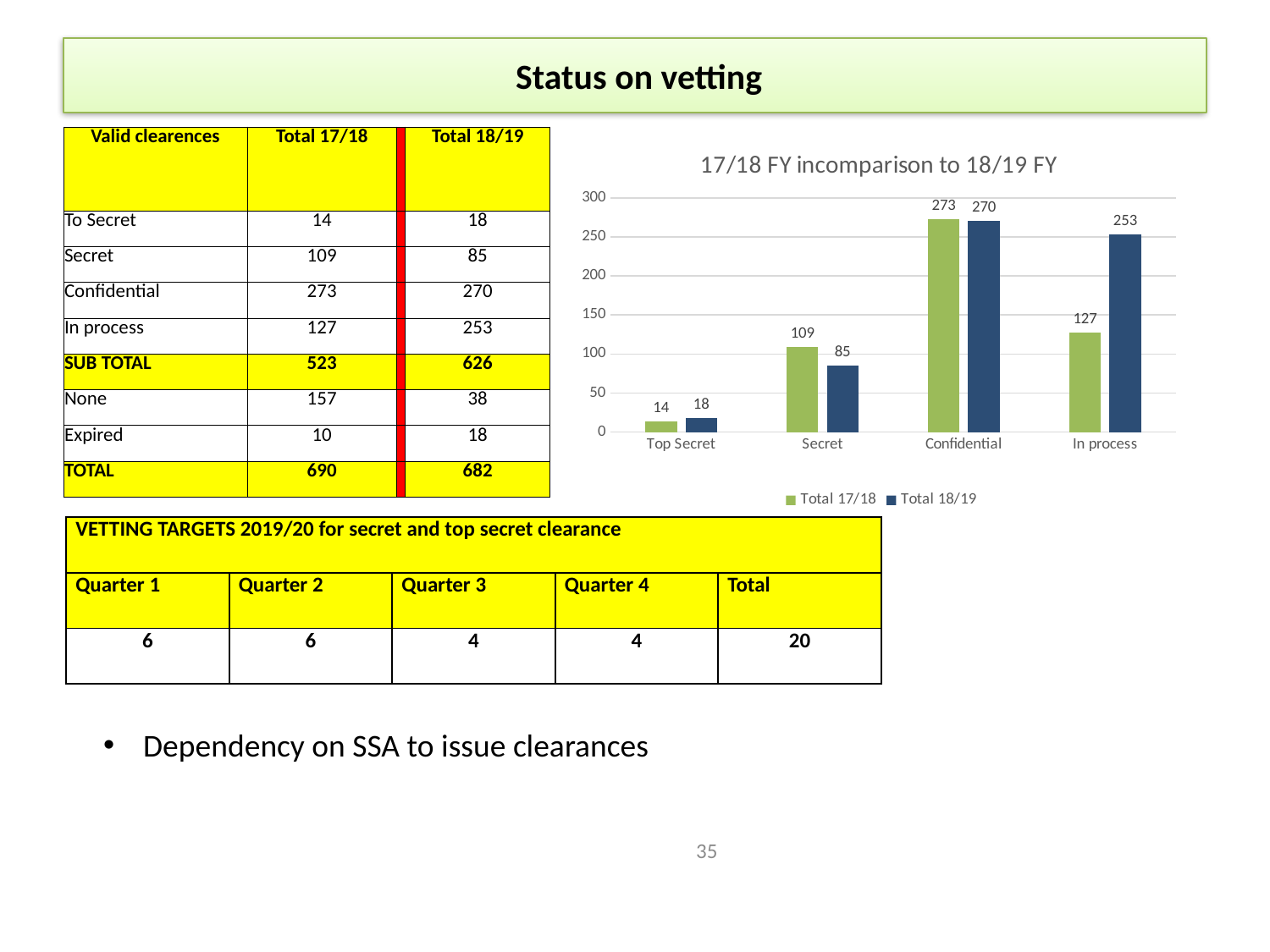
Is the value for Total 18/19 in the Confidential category greater or less than 250? greater Which category has the highest Total 17/18 value? Confidential What is the value for Total 18/19 in the In process category? 253 What kind of chart is shown on the slide? bar chart How many categories are shown on the x axis of the chart? 4 What is the value for Total 18/19 in the Secret category? 85 What is the value for Total 17/18 in the Confidential category? 273 What is the difference between Total 18/19 and Total 17/18 for In process? 126 Which category has the lowest Total 18/19 value? Top Secret What is the title of the chart? 17/18 FY incomparison to 18/19 FY How many series does the chart legend list? 2 Which is larger for Secret: Total 17/18 or Total 18/19? Total 17/18